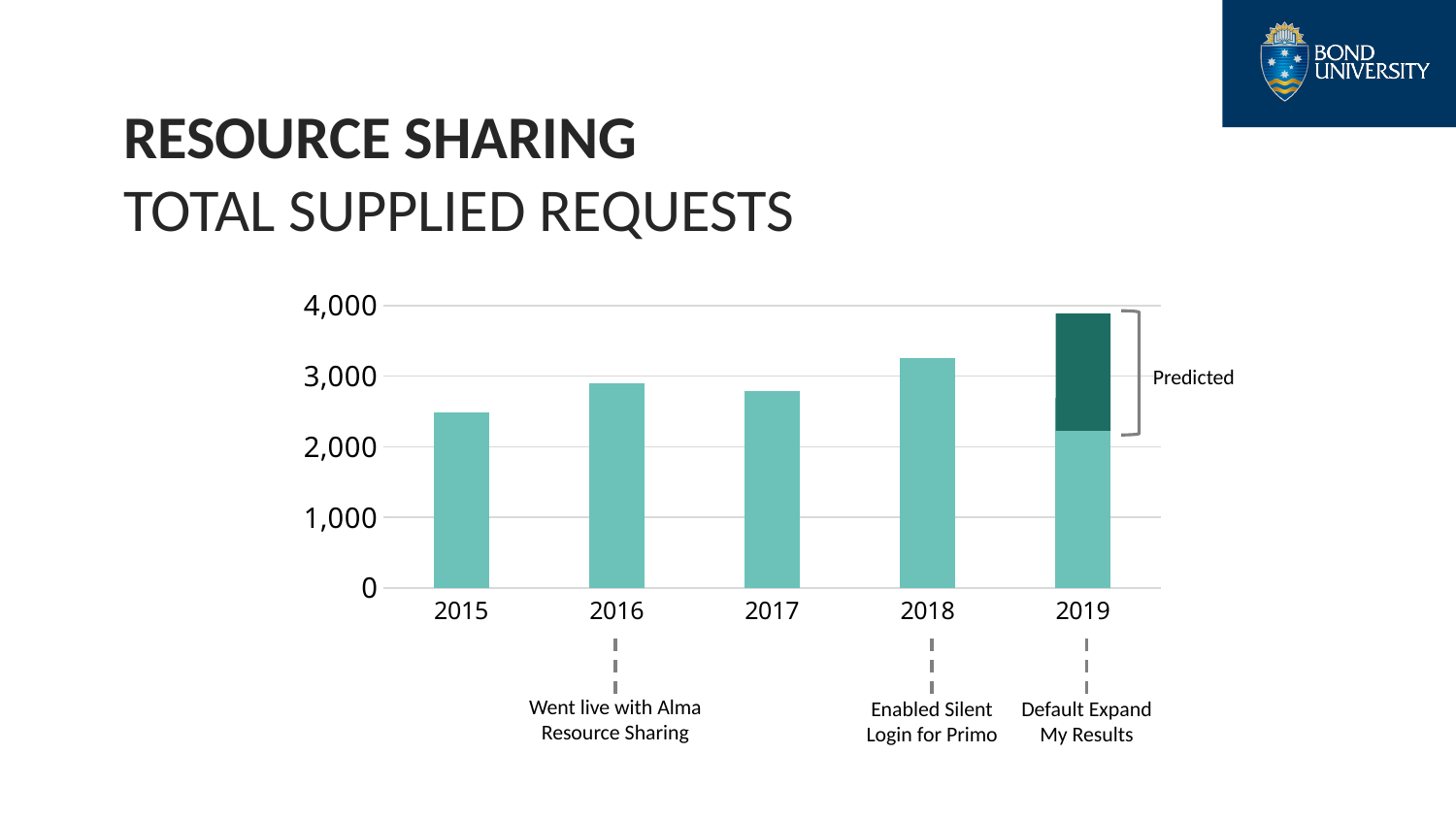
What does the dark green portion of the 2019 bar represent, according to the label beside it? Predicted Which year has the tallest bar on the chart? 2019 Among the years 2015 to 2018, which year has the lowest bar? 2015 What kind of chart is shown on the slide? bar chart How many years are shown on the x axis of the chart? 5 Is the value for 2017 greater or less than 3,000? less Is the total height of the 2019 bar, including the predicted portion, greater or less than 3,000? greater Is the value for 2018 greater or less than 3,000? greater What event is annotated below the 2016 bar? Went live with Alma Resource Sharing Which is larger, the value for 2018 or the value for 2015? 2018